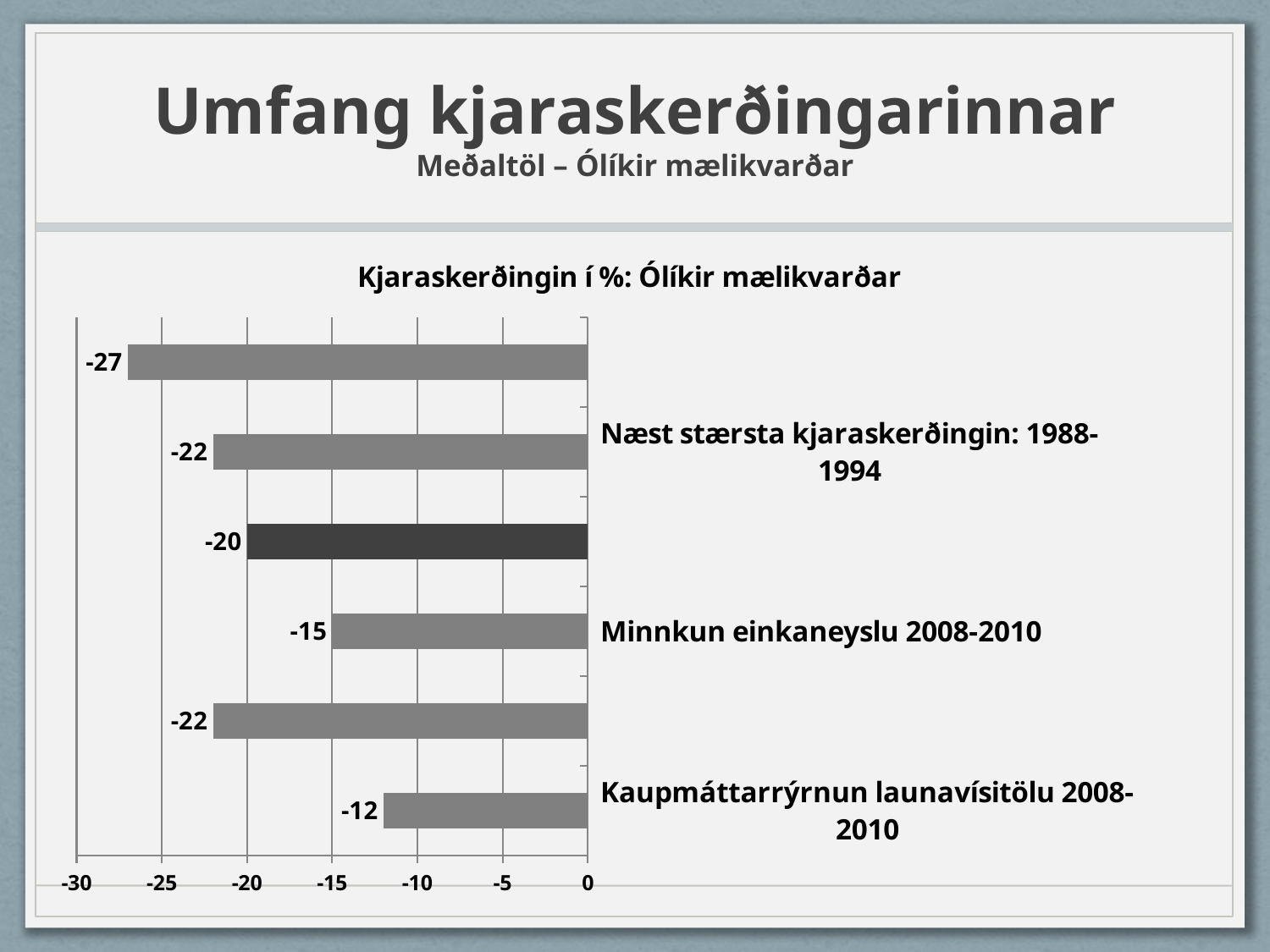
What kind of chart is shown on the slide? bar chart What is the difference between the values for Næst stærsta kjaraskerðingin: 1988-1994 and Minnkun einkaneyslu 2008-2010? 7 Is the value for Kaupmáttarrýrnun launavísitölu 2008-2010 greater or less than -15? greater Which shows the larger reduction, Minnkun einkaneyslu 2008-2010 or Kaupmáttarrýrnun launavísitölu 2008-2010? Minnkun einkaneyslu 2008-2010 How many bars on the chart have the value -22? 2 What is the value for Næst stærsta kjaraskerðingin: 1988-1994? -22 What is the value for Minnkun einkaneyslu 2008-2010? -15 What is the title of the chart? Kjaraskerðingin í %: Ólíkir mælikvarðar What is the value for Kaupmáttarrýrnun launavísitölu 2008-2010? -12 What is the lowest value shown on the chart? -27 What is the value of the bar drawn in a darker shade than the others? -20 How many bars are plotted on the chart? 6